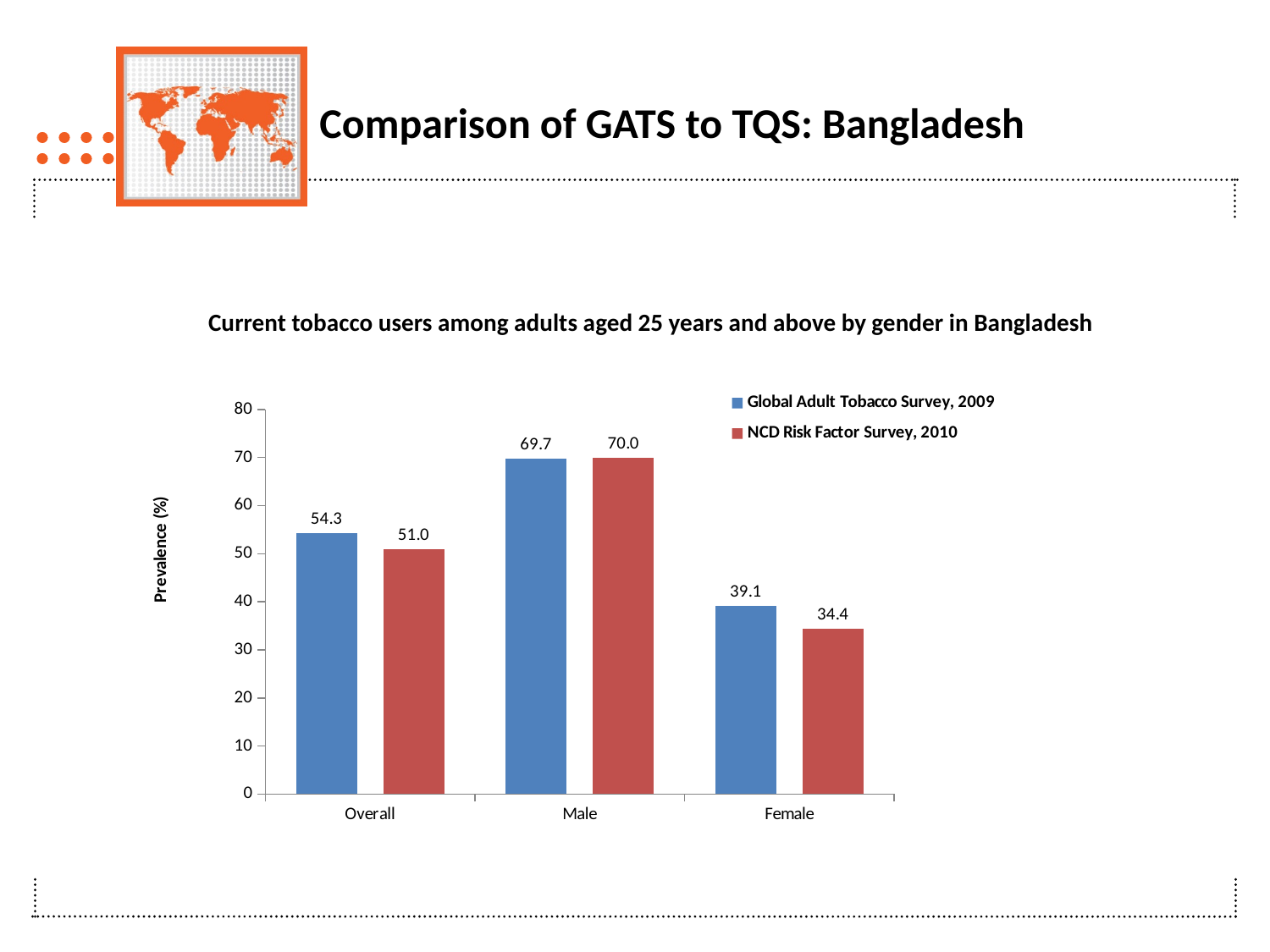
Which category has the lowest value in the NCD Risk Factor Survey, 2010 series? Female What is the label of the y axis? Prevalence (%) What is the difference between the Global Adult Tobacco Survey, 2009 and NCD Risk Factor Survey, 2010 values for Overall? 3.3 What is the difference between the Global Adult Tobacco Survey, 2009 and NCD Risk Factor Survey, 2010 values for Female? 4.7 How many categories are shown on the x axis? 3 What is the value for Female in the NCD Risk Factor Survey, 2010 series? 34.4 For Overall, which series has the larger value: Global Adult Tobacco Survey, 2009 or NCD Risk Factor Survey, 2010? Global Adult Tobacco Survey, 2009 Which category has the highest value in the Global Adult Tobacco Survey, 2009 series? Male What is the value for Male in the Global Adult Tobacco Survey, 2009 series? 69.7 What is the value for Overall in the NCD Risk Factor Survey, 2010 series? 51.0 How many series does the legend list? 2 What kind of chart is shown on the slide? bar chart